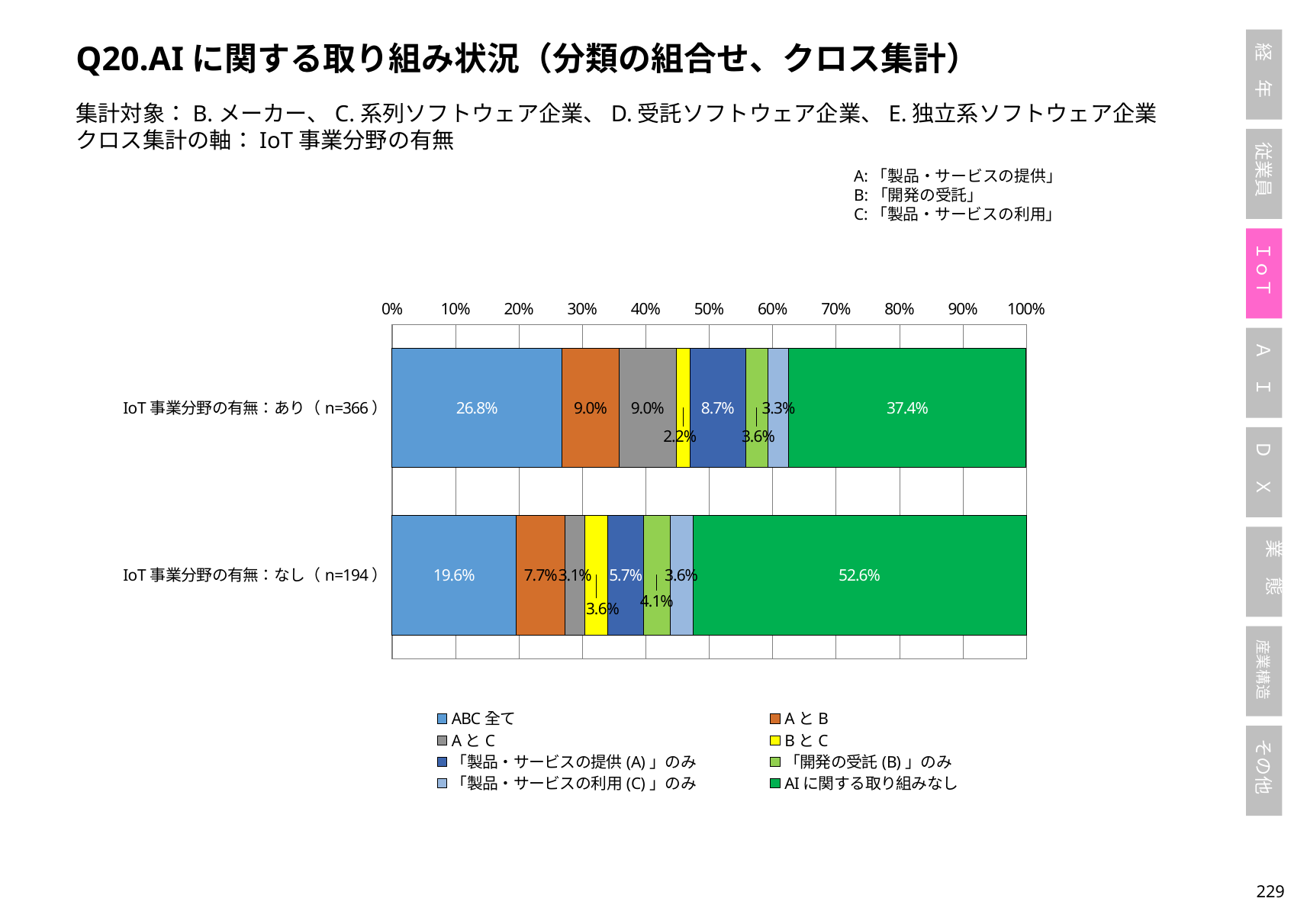
What is the sample size (n) shown for 「IoT 事業分野の有無：なし」? 194 What is the value of 「A と B」 for 「IoT 事業分野の有無：なし（n=194）」? 7.7% What is the value of 「AI に関する取り組みなし」 for 「IoT 事業分野の有無：なし（n=194）」? 52.6% What is the value of 「「製品・サービスの提供 (A)」のみ」 for 「IoT 事業分野の有無：あり（n=366）」? 8.7% What kind of chart is shown on the slide? Stacked bar chart What is the value of 「ABC 全て」 for 「IoT 事業分野の有無：あり（n=366）」? 26.8% Which segment is the largest in the bar for 「IoT 事業分野の有無：あり（n=366）」? AI に関する取り組みなし Which category has the larger value for 「ABC 全て」: 「あり（n=366）」 or 「なし（n=194）」? あり（n=366） How many categories (bars) are plotted in the chart? 2 Which segment is the smallest in the bar for 「IoT 事業分野の有無：あり（n=366）」? B と C How many series does the legend list? 8 What is the difference between the 「AI に関する取り組みなし」 values for 「なし（n=194）」 and 「あり（n=366）」? 15.2%